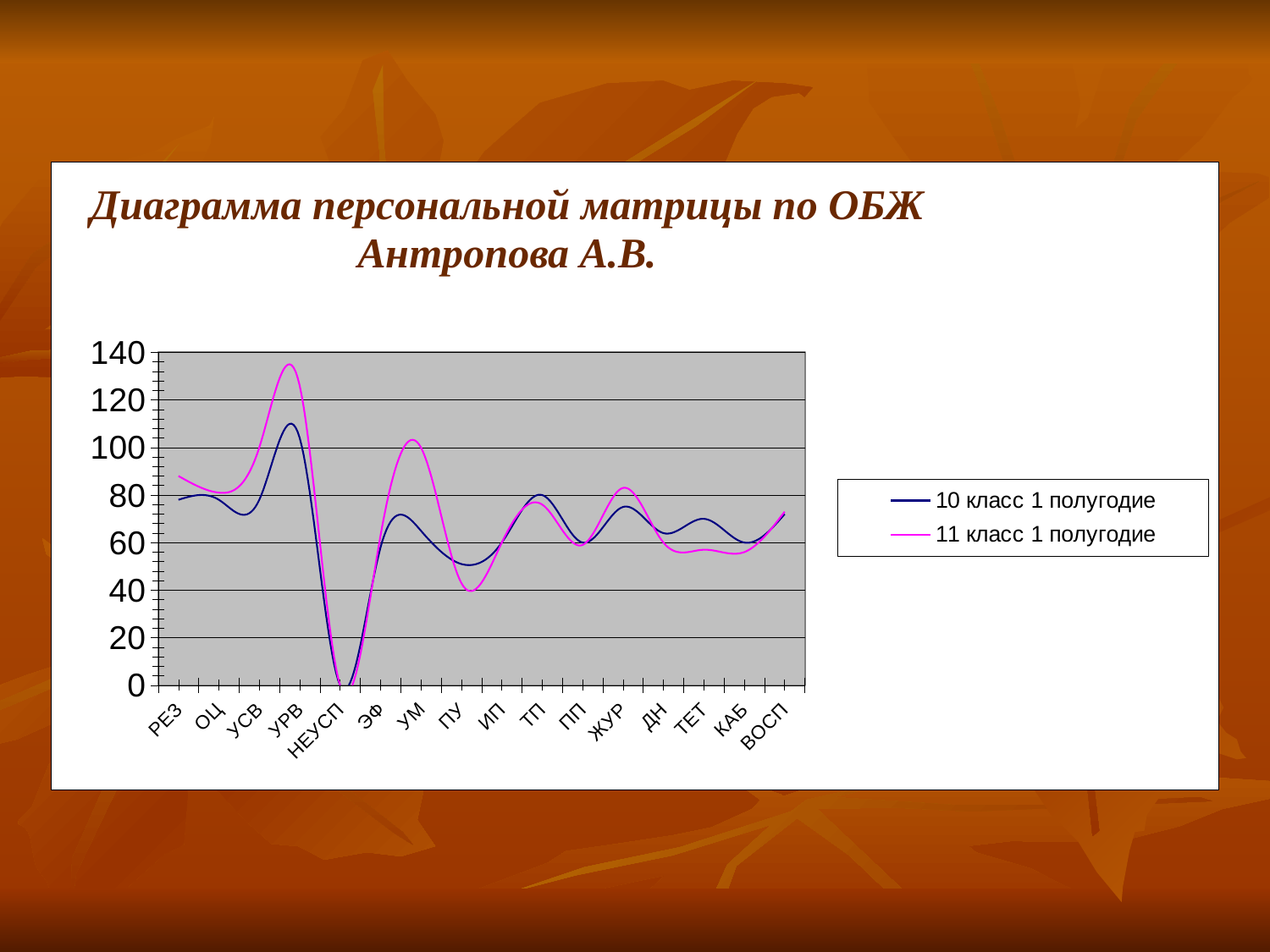
For which category is the value of the 11 класс 1 полугодие series highest? УРВ How many categories are shown along the x axis? 16 At УРВ, which series has the larger value: 10 класс 1 полугодие or 11 класс 1 полугодие? 11 класс 1 полугодие For which category is the value of the 10 класс 1 полугодие series highest? УРВ How many series does the legend list? 2 Is the value for УРВ in the 11 класс 1 полугодие series greater or less than 120? greater Is the value for УРВ in the 10 класс 1 полугодие series greater or less than 100? greater For which category is the value of the 10 класс 1 полугодие series lowest? НЕУСП What kind of chart is shown on the slide? Line chart What colour is the line for the 11 класс 1 полугодие series? Magenta (pink) At ТЕТ, which series has the larger value: 10 класс 1 полугодие or 11 класс 1 полугодие? 10 класс 1 полугодие Is the value for ПУ in the 11 класс 1 полугодие series greater or less than 60? less